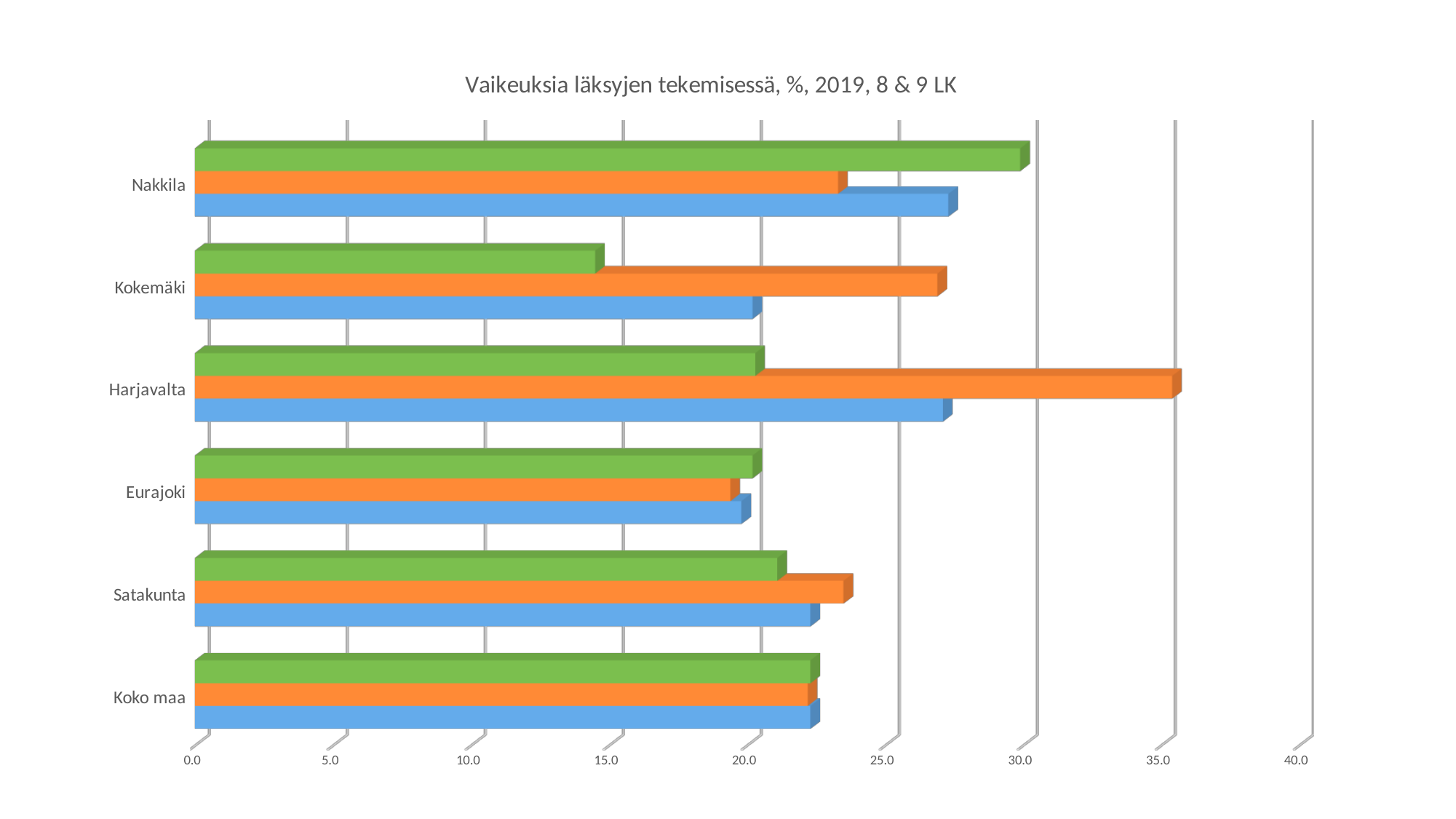
Is the green bar for Kokemäki greater or less than 20? less How many bars are plotted for each category in the chart? 3 For Kokemäki, which is larger: the orange bar or the green bar? the orange bar Which category has the shortest green bar? Kokemäki Which category has the longest green bar? Nakkila For Nakkila, which is larger: the green bar or the orange bar? the green bar What type of chart is shown on the slide? bar chart What is the title of the chart? Vaikeuksia läksyjen tekemisessä, %, 2019, 8 & 9 LK Which category has the longest bar overall in the chart? Harjavalta How many categories (areas) are shown on the vertical axis of the chart? 6 Which category has the shortest orange bar? Eurajoki Is the orange bar for Harjavalta greater or less than 30? greater